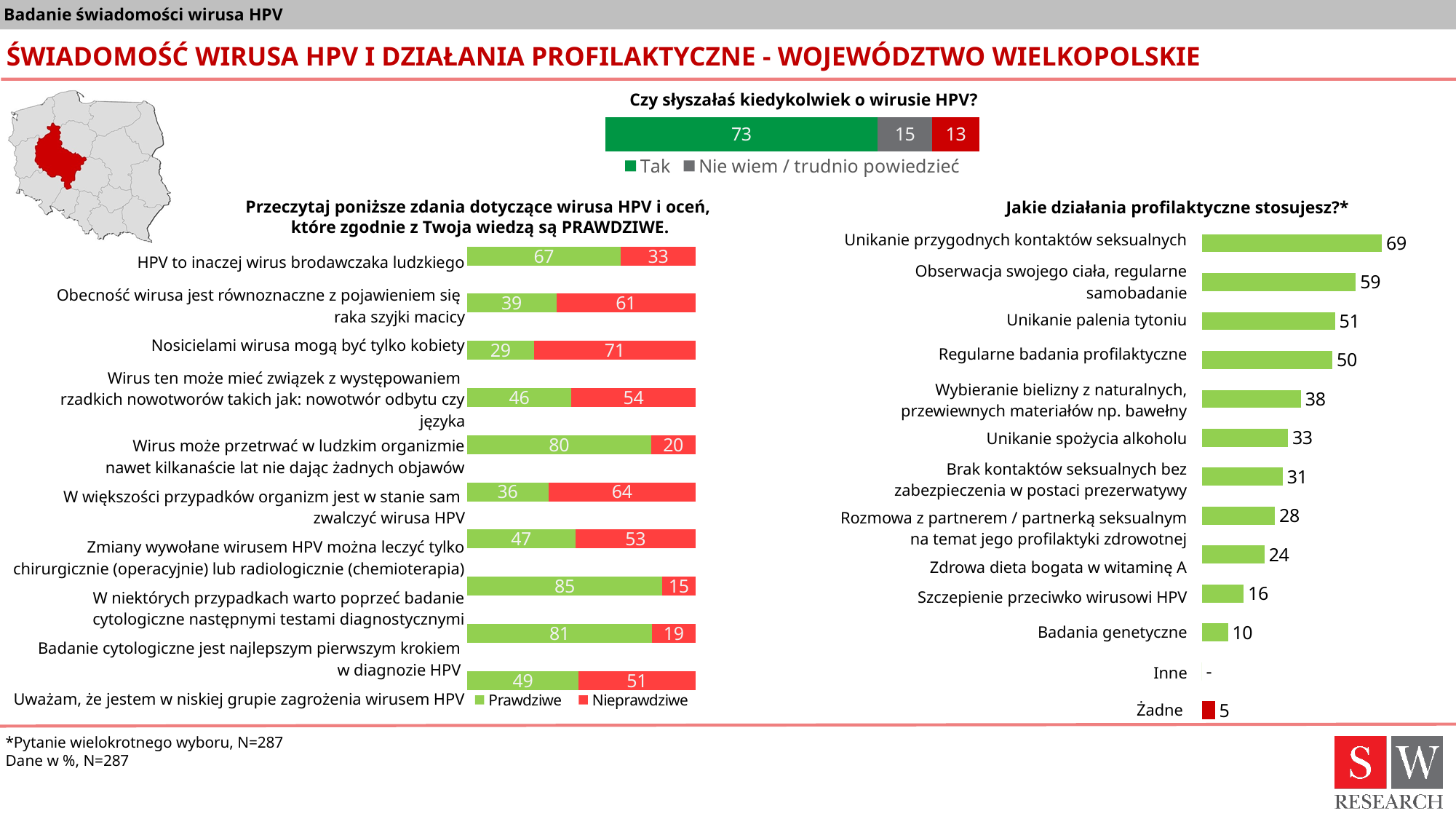
In the chart 'Przeczytaj poniższe zdania dotyczące wirusa HPV...', which statement has the highest Prawdziwe value? W niektórych przypadkach warto poprzeć badanie cytologiczne następnymi testami diagnostycznymi In the chart 'Jakie działania profilaktyczne stosujesz?', which is larger: 'Unikanie spożycia alkoholu' or 'Zdrowa dieta bogata w witaminę A'? Unikanie spożycia alkoholu In the chart 'Przeczytaj poniższe zdania dotyczące wirusa HPV...', how many series does the legend list? 2 In the chart 'Przeczytaj poniższe zdania dotyczące wirusa HPV...', what is the Nieprawdziwe value for 'Wirus może przetrwać w ludzkim organizmie nawet kilkanaście lat nie dając żadnych objawów'? 20 In the chart 'Przeczytaj poniższe zdania dotyczące wirusa HPV...', what percentage considered 'Nosicielami wirusa mogą być tylko kobiety' to be Prawdziwe? 29 In the chart 'Jakie działania profilaktyczne stosujesz?', what is the difference between 'Unikanie palenia tytoniu' and 'Regularne badania profilaktyczne'? 1 In the chart 'Jakie działania profilaktyczne stosujesz?', what is the value for 'Żadne'? 5 In the chart 'Czy słyszałaś kiedykolwiek o wirusie HPV?', what is the value of the 'Nie wiem / trudno powiedzieć' segment? 15 In the chart 'Czy słyszałaś kiedykolwiek o wirusie HPV?', what percentage answered 'Tak'? 73 In the chart 'Jakie działania profilaktyczne stosujesz?', which action has the highest value? Unikanie przygodnych kontaktów seksualnych What type of chart is 'Jakie działania profilaktyczne stosujesz?'? Bar chart In the chart 'Jakie działania profilaktyczne stosujesz?', what is the value for 'Szczepienie przeciwko wirusowi HPV'? 16